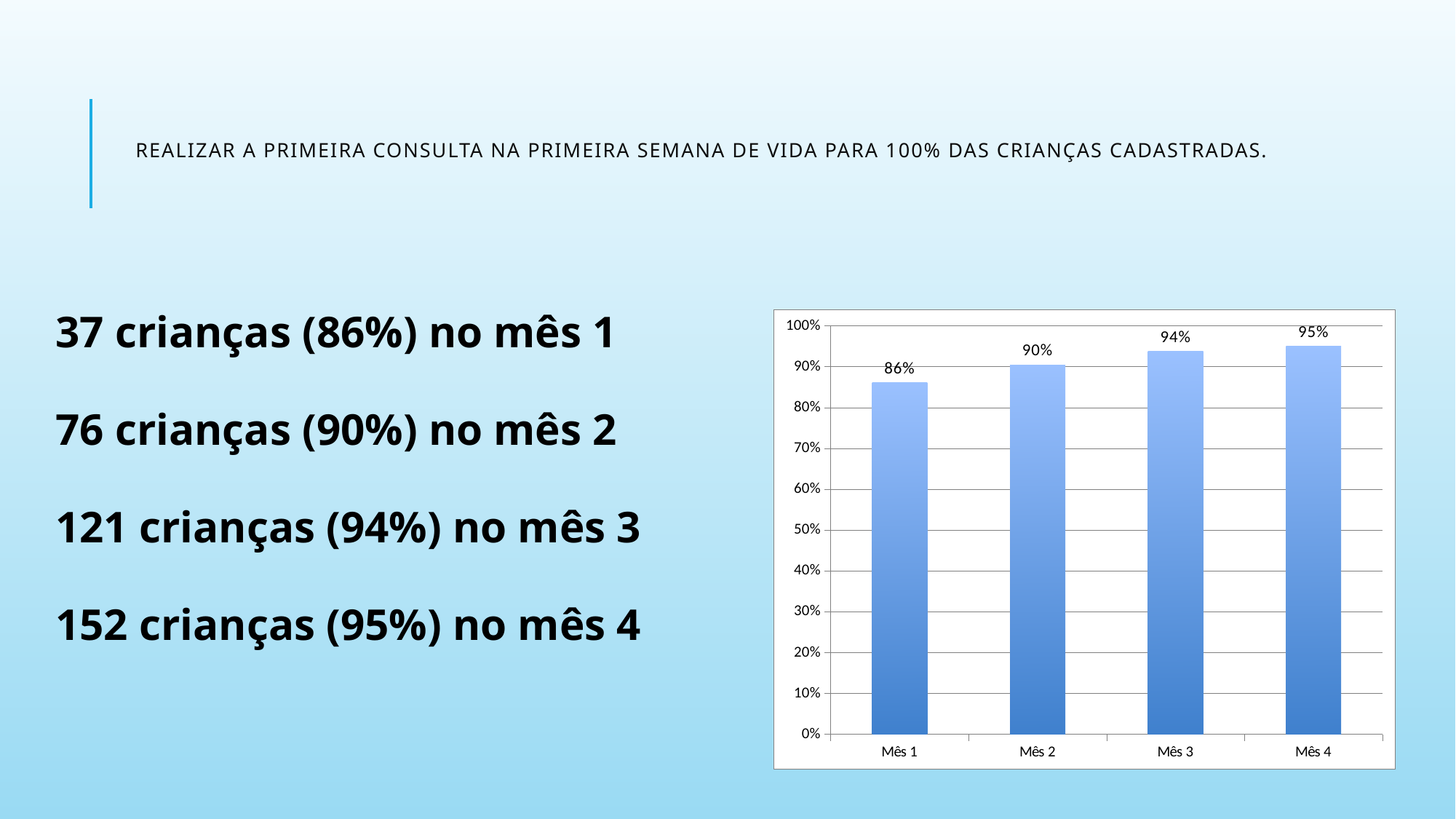
What is the value for Mês 1? 86% What kind of chart is shown on the slide? bar chart What is the difference between the values for Mês 4 and Mês 1? 9% Do the values rise or fall from Mês 1 to Mês 4? rise Which month has the highest value? Mês 4 What is the highest tick value shown on the y axis? 100% Is the value for Mês 2 greater or less than 80%? greater What is the difference between the values for Mês 2 and Mês 1? 4% What is the value for Mês 3? 94% How many months are shown on the x axis? 4 Which is larger, the value for Mês 2 or the value for Mês 3? Mês 3 Which month has the lowest value? Mês 1